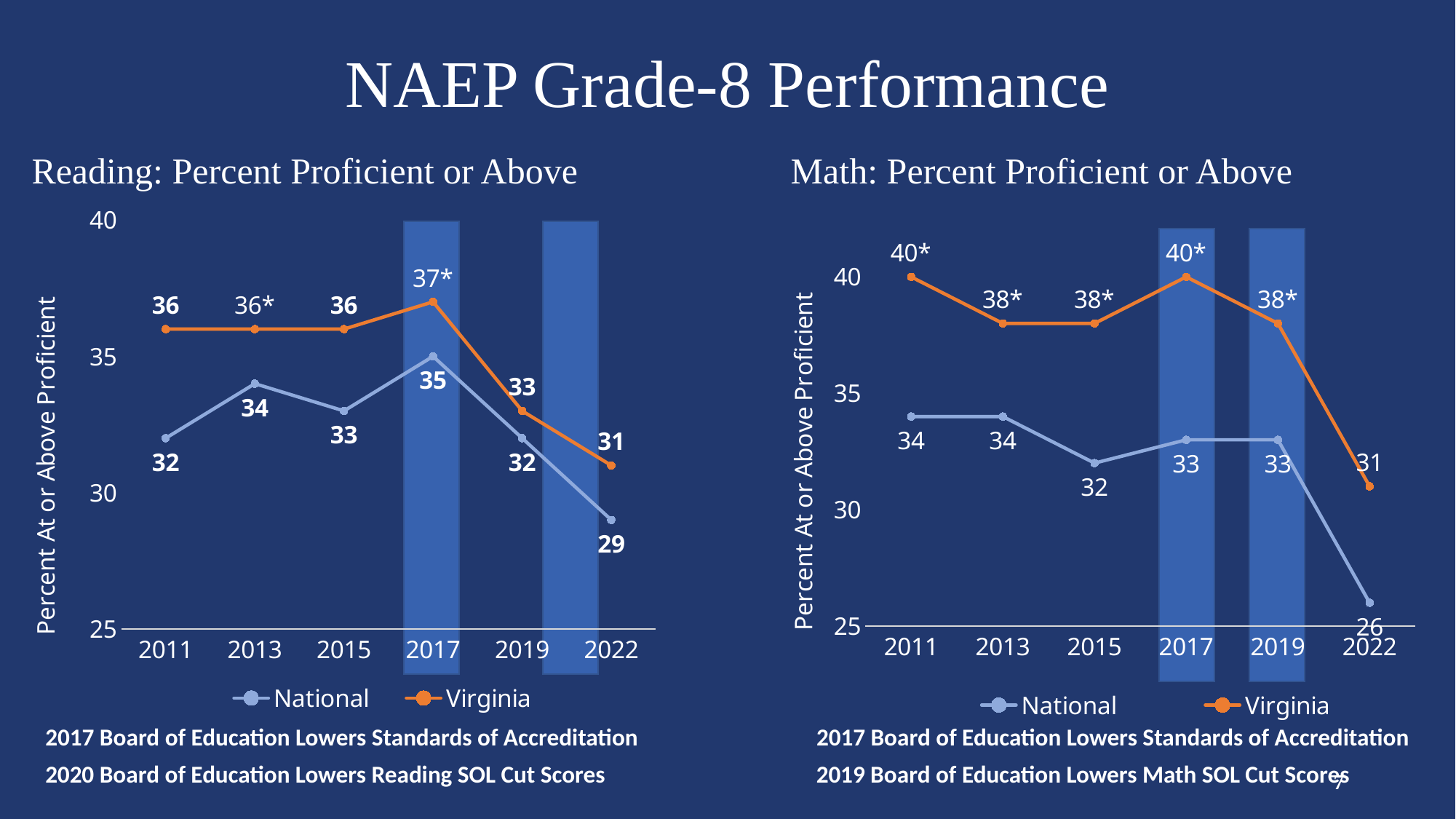
In the Reading: Percent Proficient or Above chart, what is the Virginia value for 2017? 37* In the Reading: Percent Proficient or Above chart, what is the National value for 2022? 29 In the Math: Percent Proficient or Above chart, what is the difference between the Virginia and National values in 2022? 5 In the Math: Percent Proficient or Above chart, what is the National value for 2022? 26 In the Reading: Percent Proficient or Above chart, what is the difference between the Virginia and National values in 2019? 1 How many series does the legend of the Math: Percent Proficient or Above chart list? 2 What kind of chart is the Reading: Percent Proficient or Above chart? Line chart In the Math: Percent Proficient or Above chart, which is larger in 2015, the Virginia value or the National value? Virginia How many years are plotted on the x axis of the Reading: Percent Proficient or Above chart? 6 In the Math: Percent Proficient or Above chart, what is the Virginia value for 2013? 38* In the Reading: Percent Proficient or Above chart, which year has the lowest National value? 2022 In the Math: Percent Proficient or Above chart, which year has the lowest Virginia value? 2022